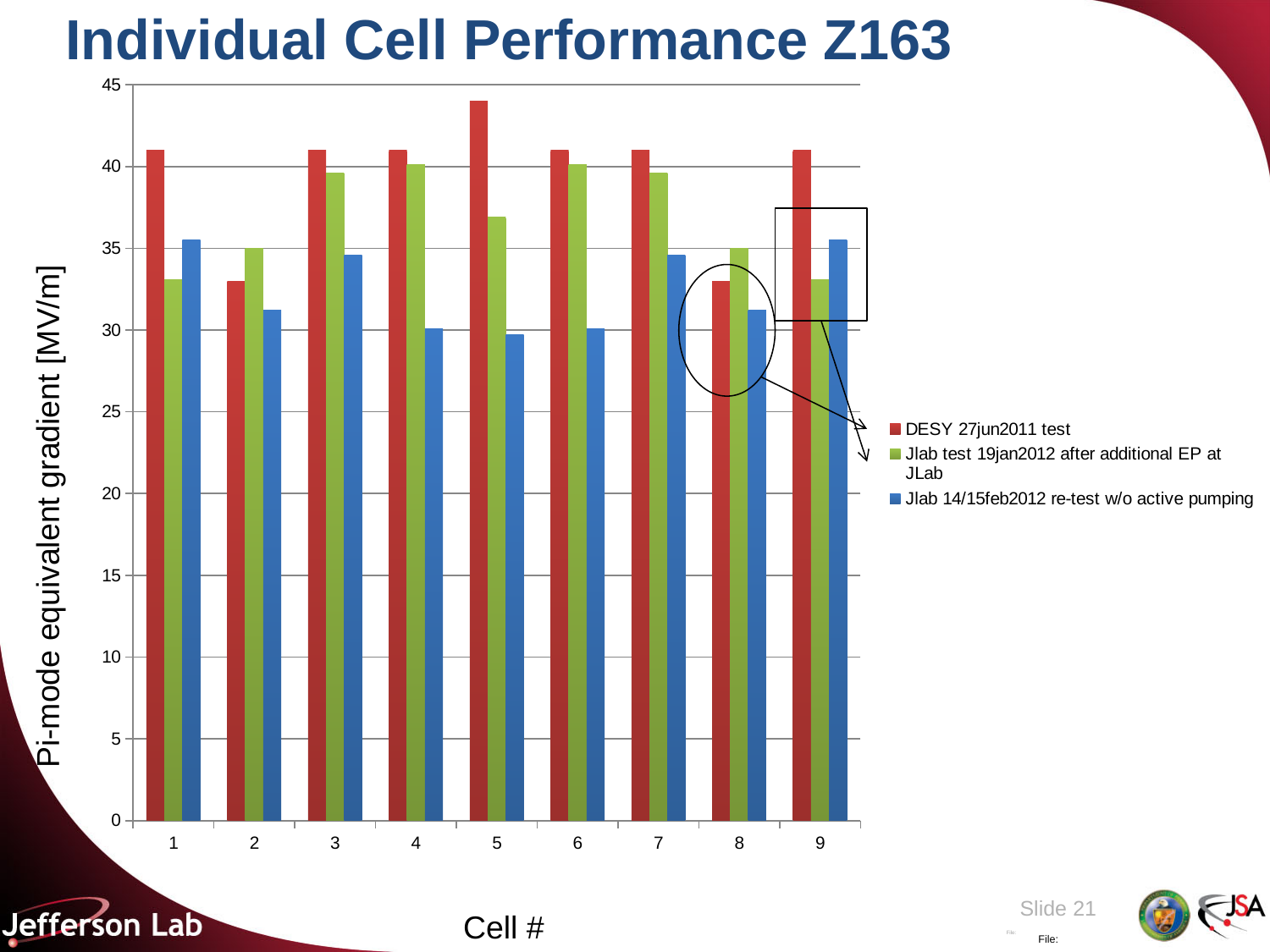
For cell 5, which is larger: the DESY 27jun2011 test value or the Jlab test 19jan2012 after additional EP at JLab value? DESY 27jun2011 test Is the DESY 27jun2011 test value for cell 2 greater or less than 35? less Is the Jlab test 19jan2012 after additional EP at JLab value for cell 8 greater or less than 30? greater What is the y-axis title of the chart? Pi-mode equivalent gradient [MV/m] For cell 2, which is larger: the DESY 27jun2011 test value or the Jlab test 19jan2012 after additional EP at JLab value? Jlab test 19jan2012 after additional EP at JLab How many series does the legend list? 3 What kind of chart is shown on the slide? bar chart For which cell is the DESY 27jun2011 test value highest? 5 How many cells (categories) are plotted along the x axis? 9 Which colour represents the Jlab 14/15feb2012 re-test w/o active pumping series? blue Is the DESY 27jun2011 test value for cell 5 greater or less than 40? greater